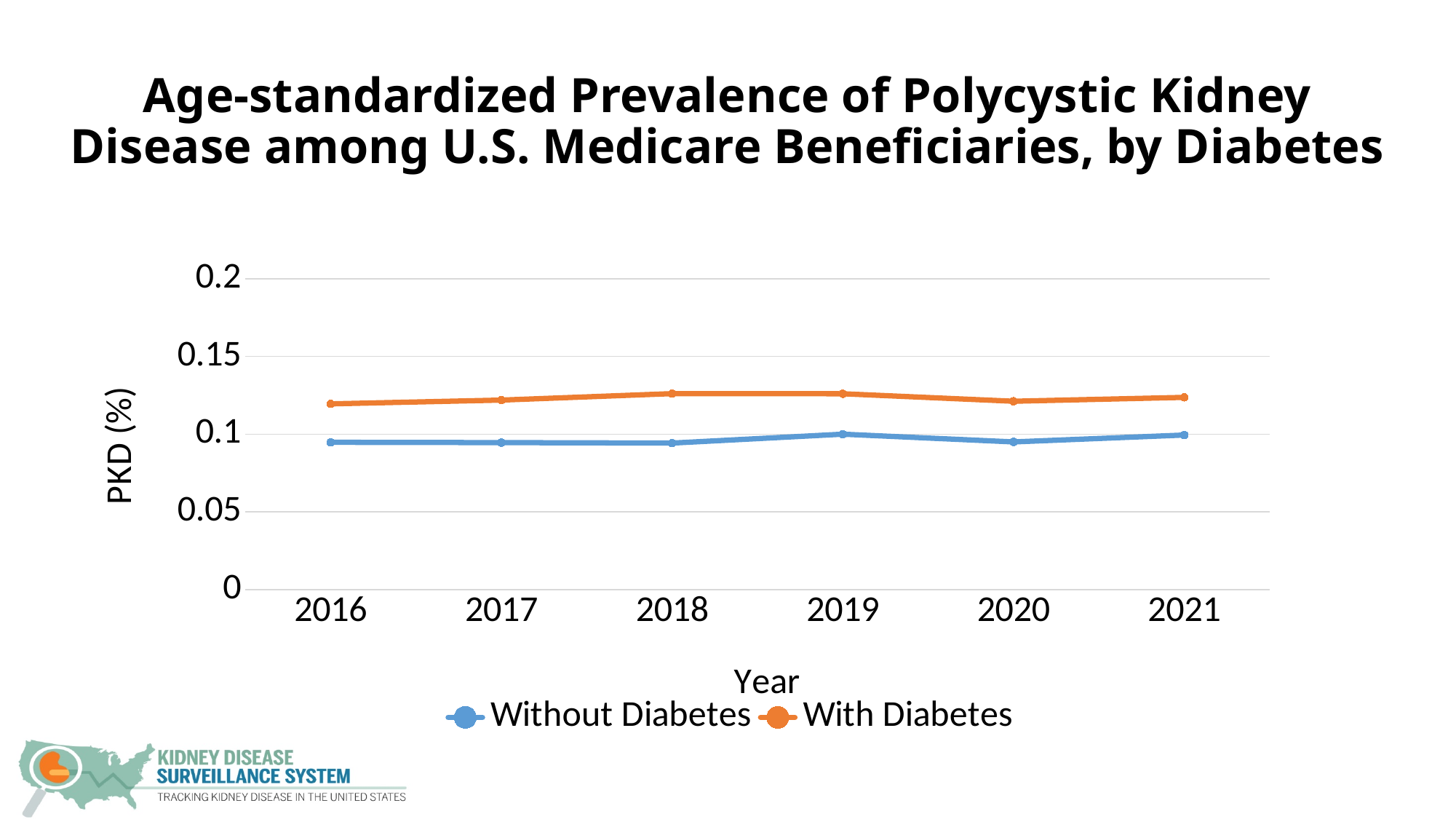
Is the value for Without Diabetes in 2017 greater or less than 0.05? greater Is the value for With Diabetes in 2016 greater or less than 0.1? greater Is the value for With Diabetes in 2019 greater or less than 0.15? less How many years are plotted along the x axis? 6 What colour is the line for With Diabetes? orange What kind of chart is shown on the slide? line chart Which series has the higher value in 2018, With Diabetes or Without Diabetes? With Diabetes Which series has the lower value in 2021, With Diabetes or Without Diabetes? Without Diabetes How many series does the legend list? 2 What is the first year shown on the x axis? 2016 What is the label of the y axis? PKD (%)